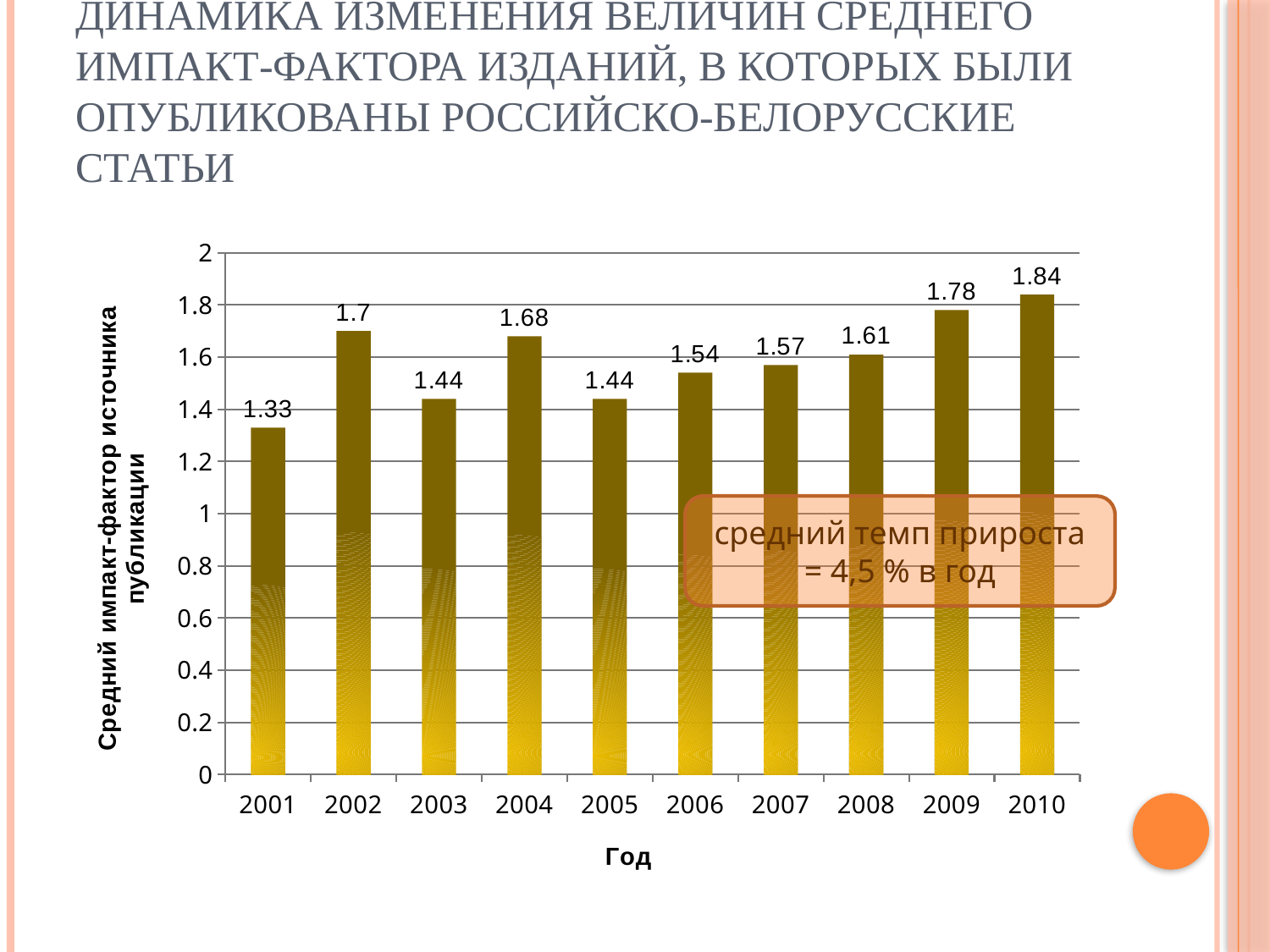
What is the average impact factor value for 2001? 1.33 What is the difference between the values for 2010 and 2001? 0.51 What is the average impact factor value for 2006? 1.54 What is the label of the x axis? Год Which year has a larger value, 2004 or 2008? 2004 Which year has the highest average impact factor? 2010 Which year has the lowest average impact factor? 2001 What is the difference between the values for 2002 and 2003? 0.26 What is the average impact factor value for 2009? 1.78 How many years are shown on the x axis? 10 What kind of chart is shown on the slide? Bar chart What average annual growth rate is stated in the callout box on the chart? 4,5 % в год